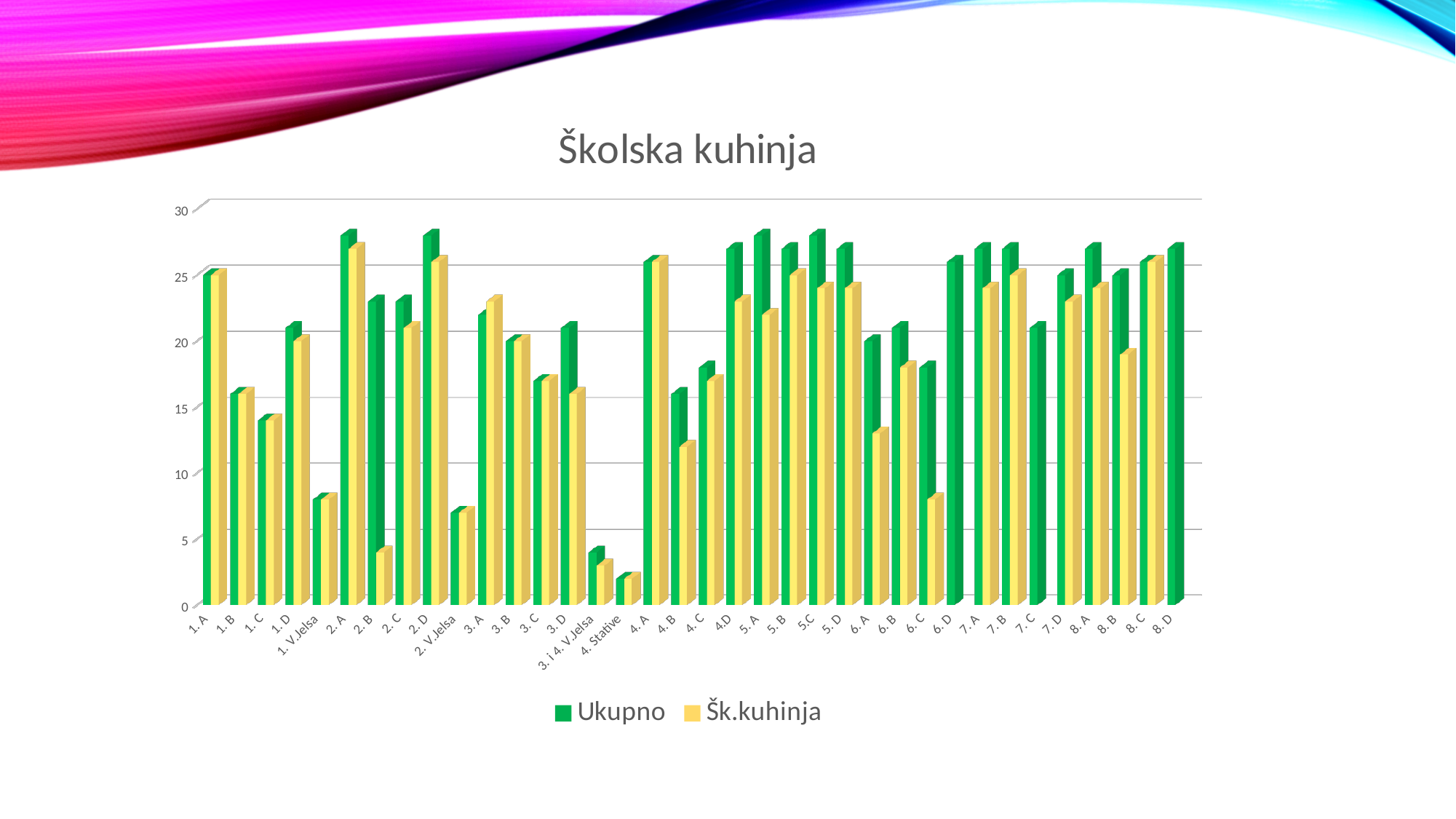
Is the Šk.kuhinja value for 4. B greater or less than 10? greater For 2. B, which is larger: the Ukupno value or the Šk.kuhinja value? Ukupno Is the Šk.kuhinja value for 6. C greater or less than 10? less Is the Ukupno value for 2. A greater or less than 25? greater What is the title of the chart? Školska kuhinja Which category has the lowest Ukupno value? 4. Stative How many series does the legend list? 2 What kind of chart is shown on the slide? bar chart How many categories are shown on the x axis? 36 Which two series are listed in the legend? Ukupno and Šk.kuhinja